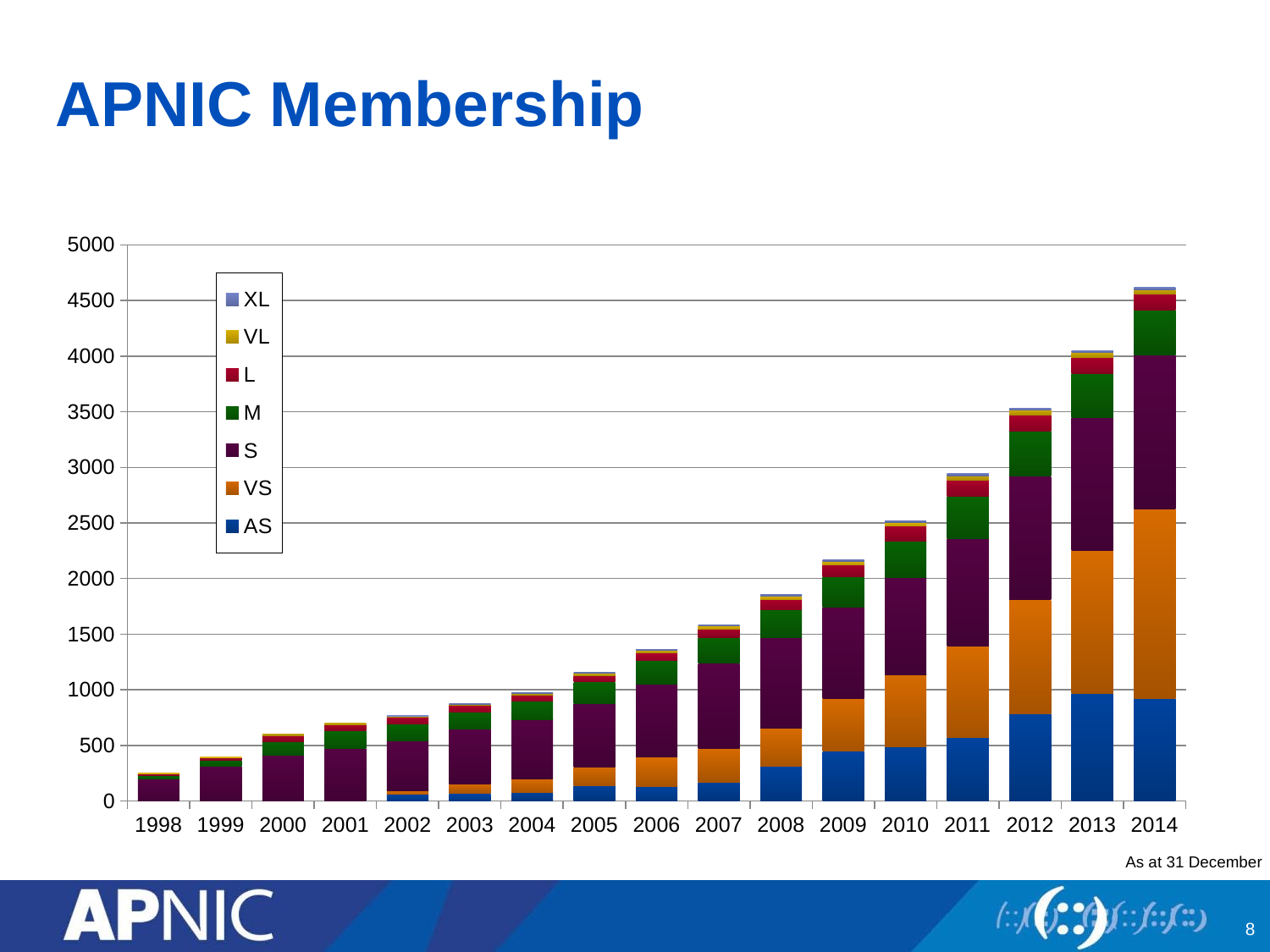
Which year has the larger total bar, 2012 or 2013? 2013 In the 2014 bar, which segment is larger, AS or VS? VS How many series does the chart's legend list? 7 Which year has the shortest stacked bar? 1998 Is the total bar height for 2014 greater or less than 4000? greater Is the total bar height for 2008 greater or less than 2000? less Do the total bar heights rise or fall from 1998 to 2014? rise What kind of chart is shown on the slide? bar chart Which year has the tallest stacked bar? 2014 Is the total bar height for 1998 greater or less than 500? less How many years are shown along the x axis of the chart? 17 Which series is listed first in the chart's legend? XL